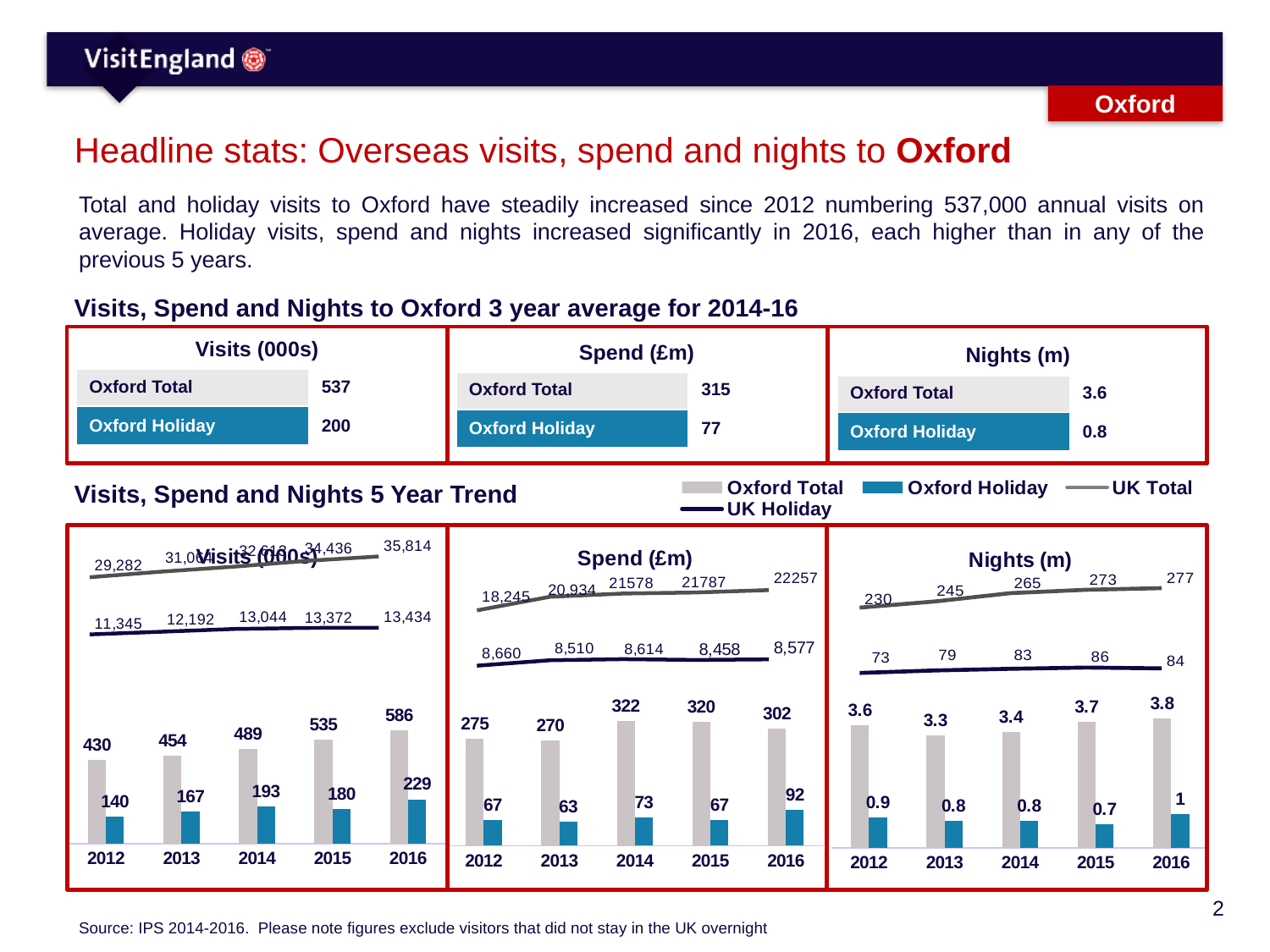
In the Spend (£m) chart, what is the Oxford Holiday value for 2016? 92 What type of chart is used to show the Oxford Total and Oxford Holiday values in the Nights (m) chart? bar chart In the Nights (m) chart, what is the UK Total value for 2014? 265 How many series does the shared legend for the 5 Year Trend charts list? 4 In the Visits (000s) chart, do the Oxford Total values rise or fall from 2012 to 2016? rise In the Visits (000s) chart, what is the difference between the Oxford Total and Oxford Holiday values for 2015? 355 In the Nights (m) chart, what is the difference between the UK Holiday values for 2016 and 2012? 11 In the Visits (000s) chart, what is the Oxford Total value for 2016? 586 In the Spend (£m) chart, which year has the highest Oxford Total value? 2014 In the Visits (000s) chart, which year has the lowest Oxford Holiday value? 2012 In the Spend (£m) chart, is the Oxford Holiday value larger in 2013 or in 2014? 2014 How many years are shown on the x axis of the Spend (£m) chart? 5